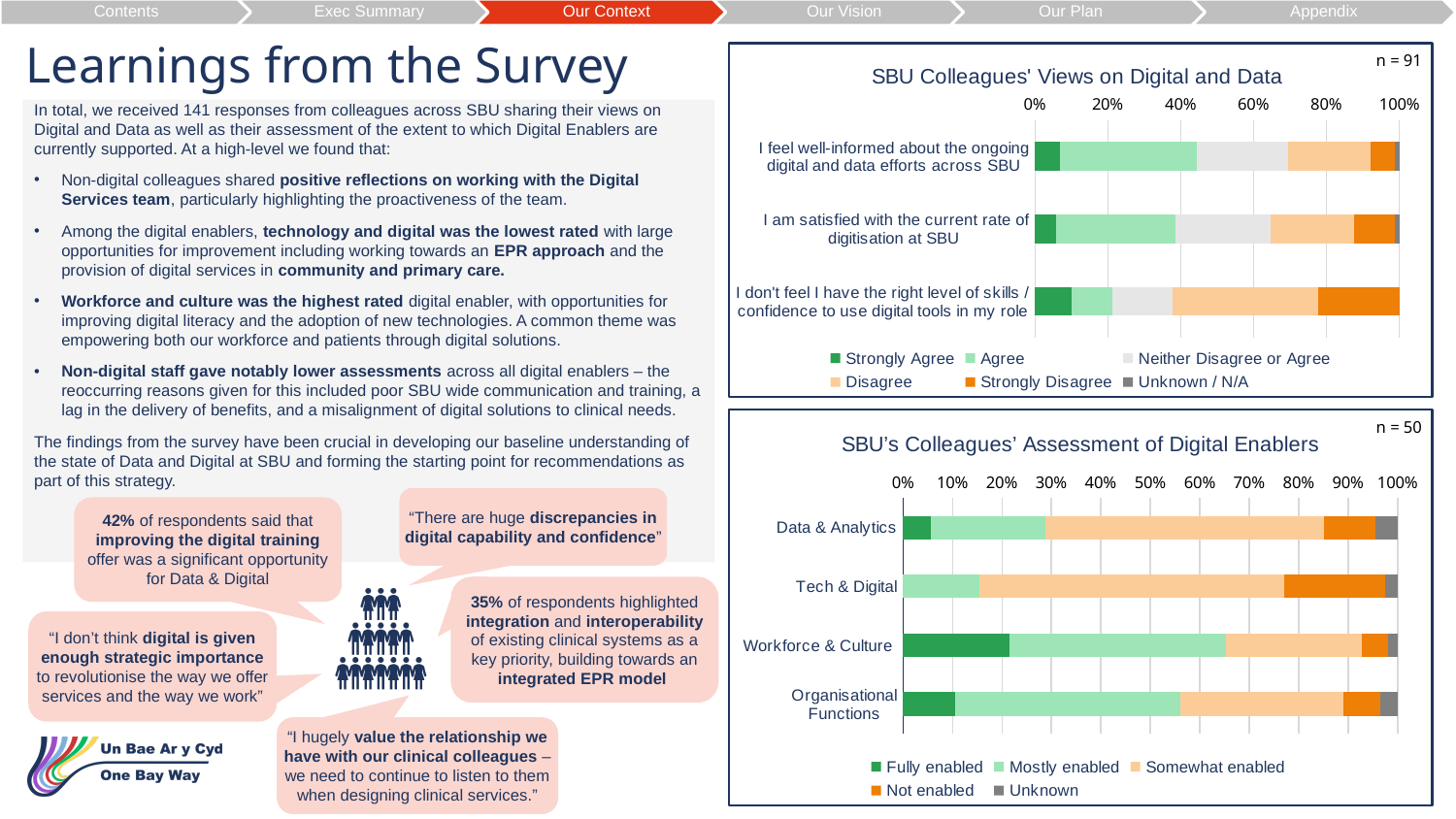
In the 'SBU's Colleagues' Assessment of Digital Enablers' chart, which enabler has the largest 'Not enabled' segment? Tech & Digital How many digital enablers are plotted in the 'SBU's Colleagues' Assessment of Digital Enablers' chart? 4 In the 'SBU Colleagues' Views on Digital and Data' chart, which statement has the largest 'Strongly Disagree' segment? I don't feel I have the right level of skills / confidence to use digital tools in my role How many series does the legend of the 'SBU Colleagues' Views on Digital and Data' chart list? 6 What sample size (n) is shown for the 'SBU's Colleagues' Assessment of Digital Enablers' chart? n = 50 In the 'SBU Colleagues' Views on Digital and Data' chart, which statement has the smallest 'Agree' segment? I don't feel I have the right level of skills / confidence to use digital tools in my role In the 'SBU's Colleagues' Assessment of Digital Enablers' chart, which enabler has the largest 'Fully enabled' segment? Workforce & Culture How many series does the legend of the 'SBU's Colleagues' Assessment of Digital Enablers' chart list? 5 What kind of chart is 'SBU Colleagues' Views on Digital and Data'? Stacked bar chart What sample size (n) is shown for the 'SBU Colleagues' Views on Digital and Data' chart? n = 91 What kind of chart is 'SBU's Colleagues' Assessment of Digital Enablers'? Stacked bar chart How many statements are plotted in the 'SBU Colleagues' Views on Digital and Data' chart? 3